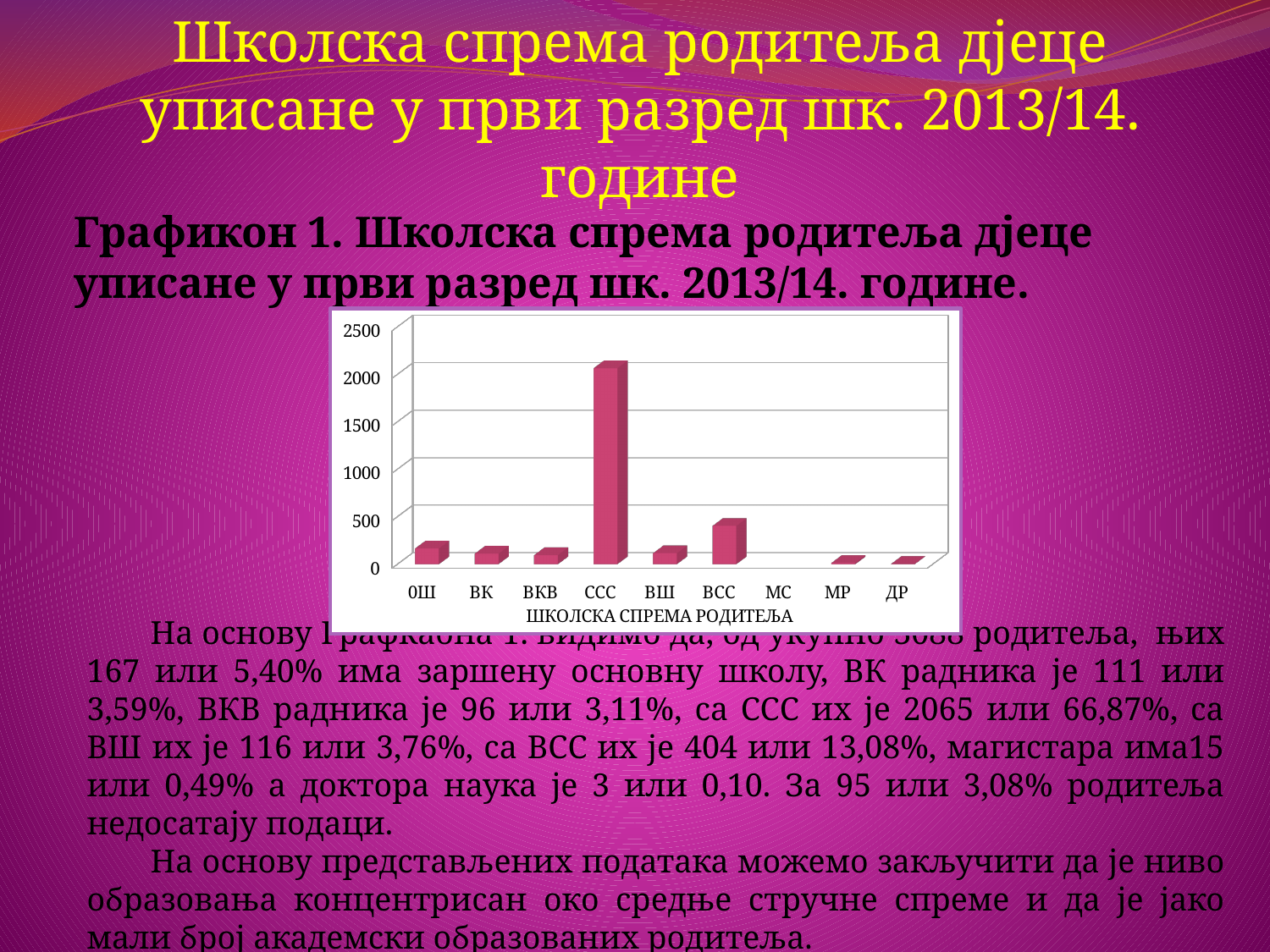
What kind of chart is shown on the slide? bar chart Is the value for ВШ greater or less than 1000? less Is the value for ОШ greater or less than 500? less Which category has the highest bar in the chart? ССС Is the value for ВСС greater or less than 500? less Which is larger, the value for ВСС or the value for ОШ? ВСС What is the highest tick value shown on the y axis of the chart? 2500 What is the title of the x axis of the chart? ШКОЛСКА СПРЕМА РОДИТЕЉА Which is larger, the value for ССС or the value for ВСС? ССС Which is larger, the value for ОШ or the value for ВКВ? ОШ How many categories are shown on the x axis of the chart? 9